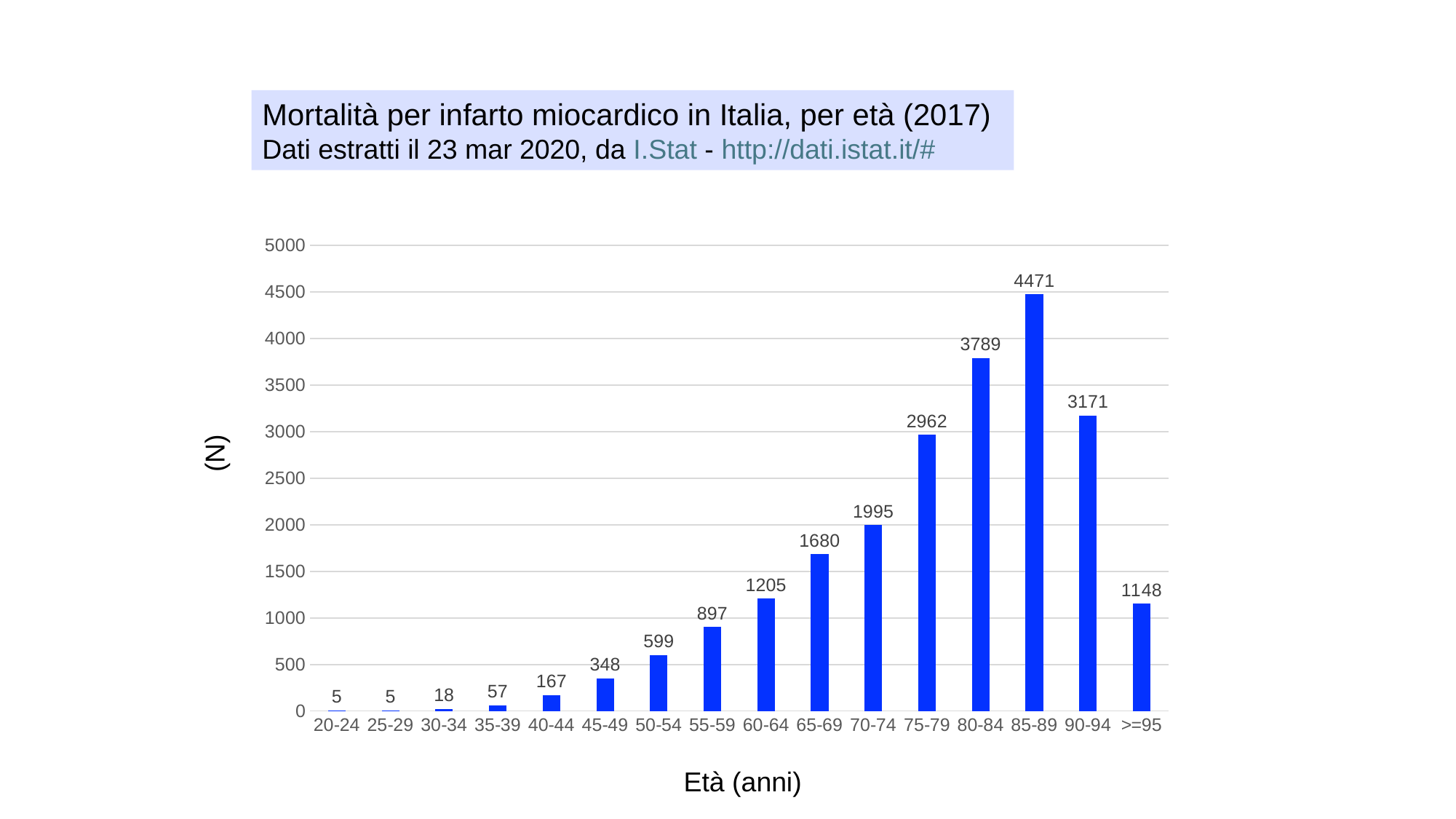
What is the value for the 85-89 age group? 4471 What kind of chart is this? bar chart What is the difference between the values for 85-89 and 80-84? 682 What is the value for the >=95 age group? 1148 Which is larger, the value for 90-94 or the value for 75-79? 90-94 Which age group has the highest value? 85-89 Is the value for 70-74 greater or less than 1500? greater What is the value for the 60-64 age group? 1205 Do the values rise or fall from the 20-24 group to the 85-89 group? rise What is the label of the x axis? Età (anni) Which age group has the lowest value? 20-24 and 25-29 (both 5) How many age groups are shown on the x axis? 16